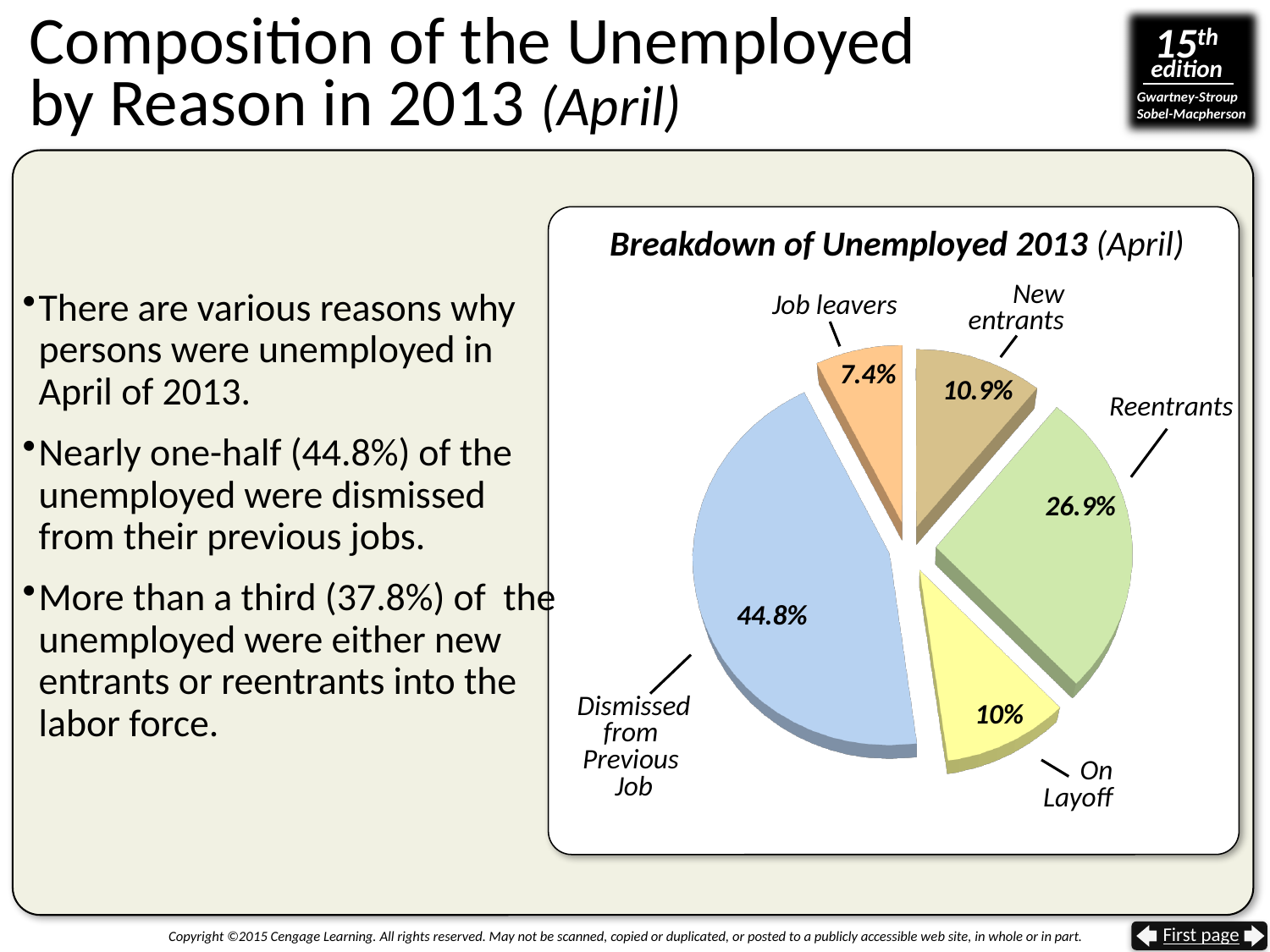
Which reason accounts for the largest share of the unemployed? Dismissed from Previous Job What share of the unemployed were reentrants? 26.9% Which slice is larger, New entrants or On Layoff? New entrants What is the difference in percentage points between the Reentrants slice and the New entrants slice? 16 percentage points What share of the unemployed were new entrants? 10.9% What share of the unemployed were job leavers? 7.4% What kind of chart is shown on the slide? Pie chart What is the title of the chart? Breakdown of Unemployed 2013 (April) What share of the unemployed were on layoff? 10% How many categories does the pie chart show? 5 What share of the unemployed were dismissed from their previous job? 44.8% Which reason accounts for the smallest share of the unemployed? Job leavers